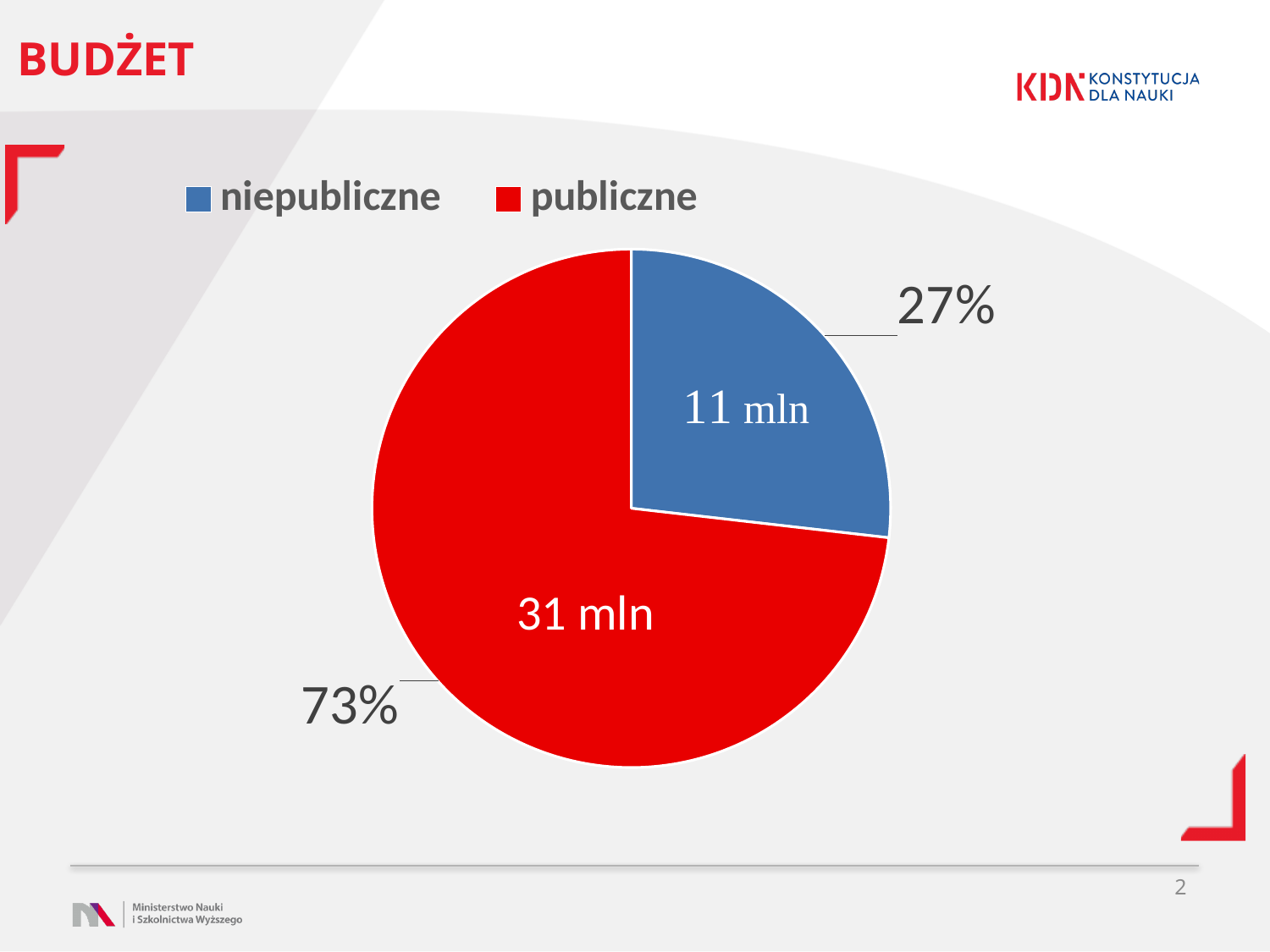
How many slices does the pie chart have? 2 What is the value for publiczne? 31 mln What is the value for niepubliczne? 11 mln Which is larger, publiczne or niepubliczne? publiczne What is the total of the two slices? 42 mln What colour is the niepubliczne slice? blue Which category has the largest slice? publiczne What share of the pie does niepubliczne take? 27% What is the difference between the values for publiczne and niepubliczne? 20 mln Which category has the smallest slice? niepubliczne What share of the pie does publiczne take? 73% What kind of chart is shown on the slide? pie chart